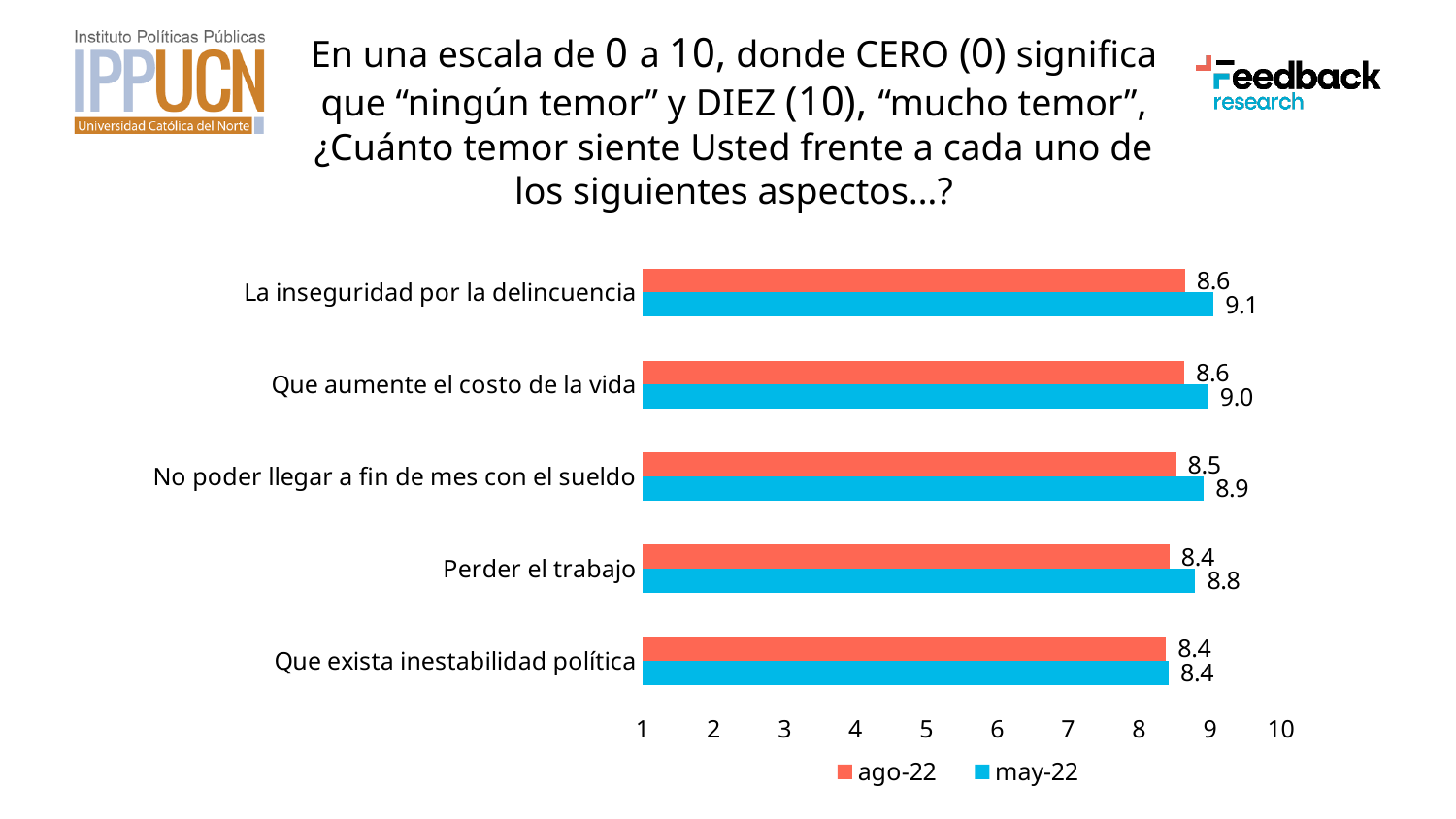
How many series does the legend list? 2 What is the may-22 value for "No poder llegar a fin de mes con el sueldo"? 8.9 How many categories are shown in the chart? 5 What is the may-22 value for "Perder el trabajo"? 8.8 What is the ago-22 value for "La inseguridad por la delincuencia"? 8.6 What is the difference between the may-22 and ago-22 values for "La inseguridad por la delincuencia"? 0.5 Which colour represents the may-22 series? blue What kind of chart is shown on the slide? bar chart Which category has the lowest may-22 value? Que exista inestabilidad política For "Que aumente el costo de la vida", which series has the larger value, ago-22 or may-22? may-22 Which category has the highest may-22 value? La inseguridad por la delincuencia Is the ago-22 value for "Perder el trabajo" greater or less than 9? less